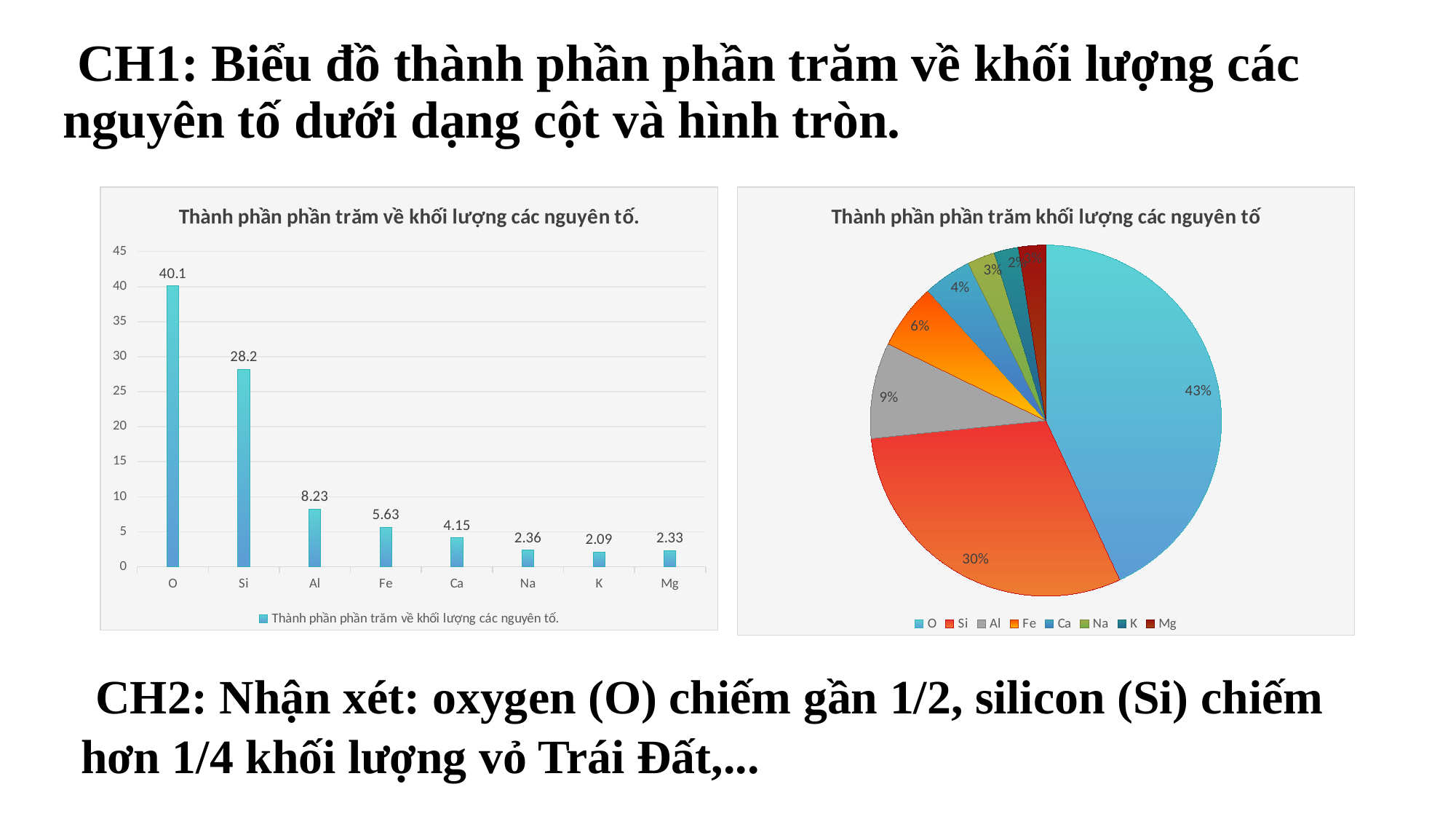
In the bar chart on the left, what is the value for Al? 8.23 In the bar chart on the left, what is the value for Fe? 5.63 In the bar chart on the left, which element has the highest value? O In the bar chart on the left, what is the difference between the values for O and Si? 11.9 In the bar chart on the left, which is larger, the value for Ca or the value for Na? Ca In the pie chart on the right, what share does Al have? 9% In the bar chart on the left, which element has the lowest value? K In the pie chart on the right, what share does Si have? 30% In the bar chart on the left, what is the value for O? 40.1 How many entries does the legend of the pie chart on the right list? 8 How many categories are shown in the bar chart on the left? 8 What kind of chart is the chart on the left? Bar chart